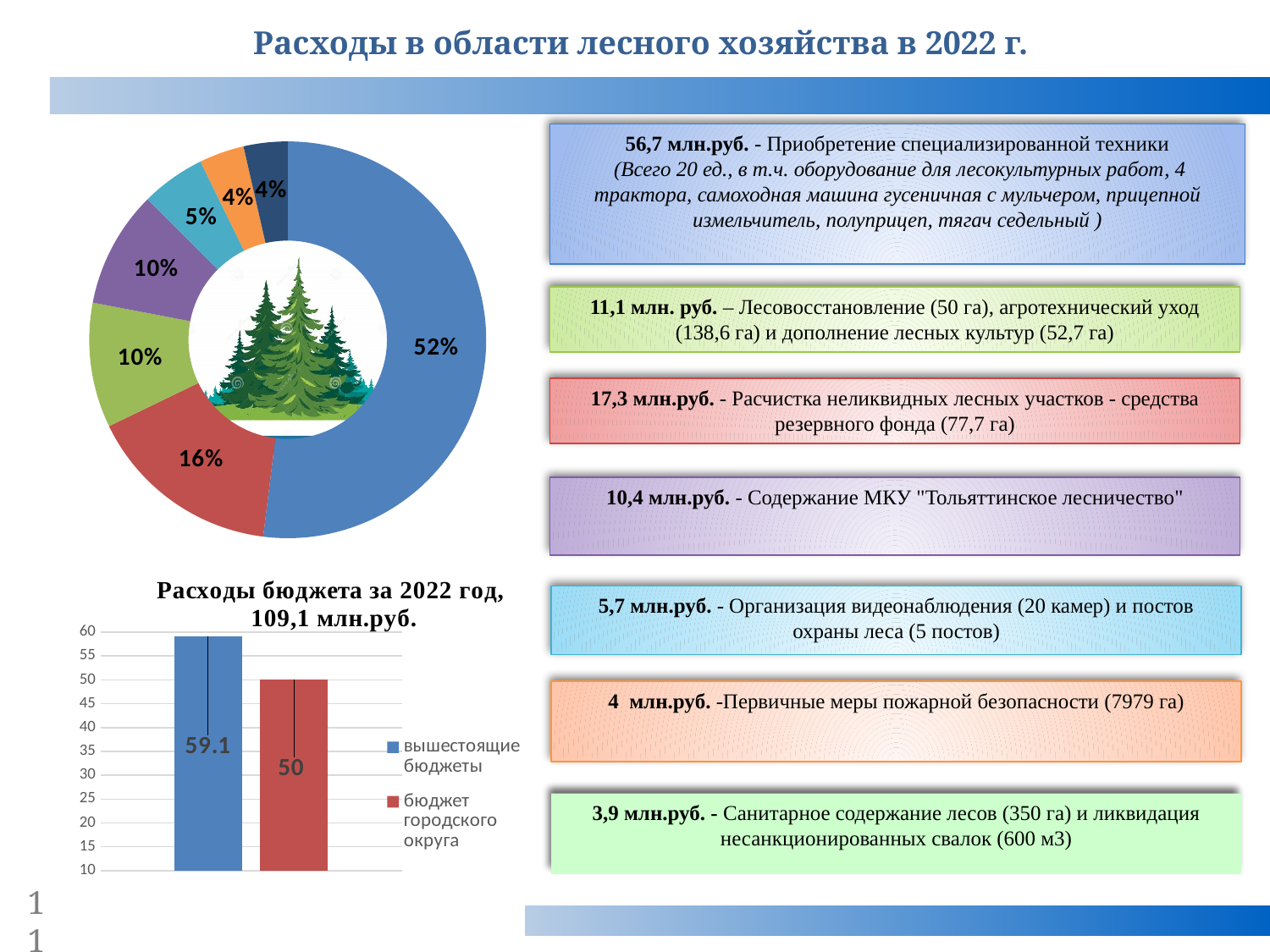
In the chart 'Расходы бюджета за 2022 год, 109,1 млн.руб.', what is the value for 'вышестоящие бюджеты'? 59.1 What kind of chart is the chart titled 'Расходы бюджета за 2022 год, 109,1 млн.руб.'? Bar chart In the chart 'Расходы бюджета за 2022 год, 109,1 млн.руб.', what is the value for 'бюджет городского округа'? 50 In the donut chart at the top left, is the blue slice's share greater or less than 50%? greater In the chart 'Расходы бюджета за 2022 год, 109,1 млн.руб.', what is the difference between 'вышестоящие бюджеты' and 'бюджет городского округа'? 9.1 In the chart 'Расходы бюджета за 2022 год, 109,1 млн.руб.', how many series does the legend list? 2 In the donut chart at the top left, what is the largest share shown? 52% In the donut chart at the top left, how many slices are shown? 7 What kind of chart is the chart at the top left of the slide? Pie chart (donut) In the chart 'Расходы бюджета за 2022 год, 109,1 млн.руб.', what colour is the bar for 'бюджет городского округа'? Red In the chart 'Расходы бюджета за 2022 год, 109,1 млн.руб.', which is larger: 'вышестоящие бюджеты' or 'бюджет городского округа'? вышестоящие бюджеты In the donut chart at the top left, what share is labelled on the red slice? 16%